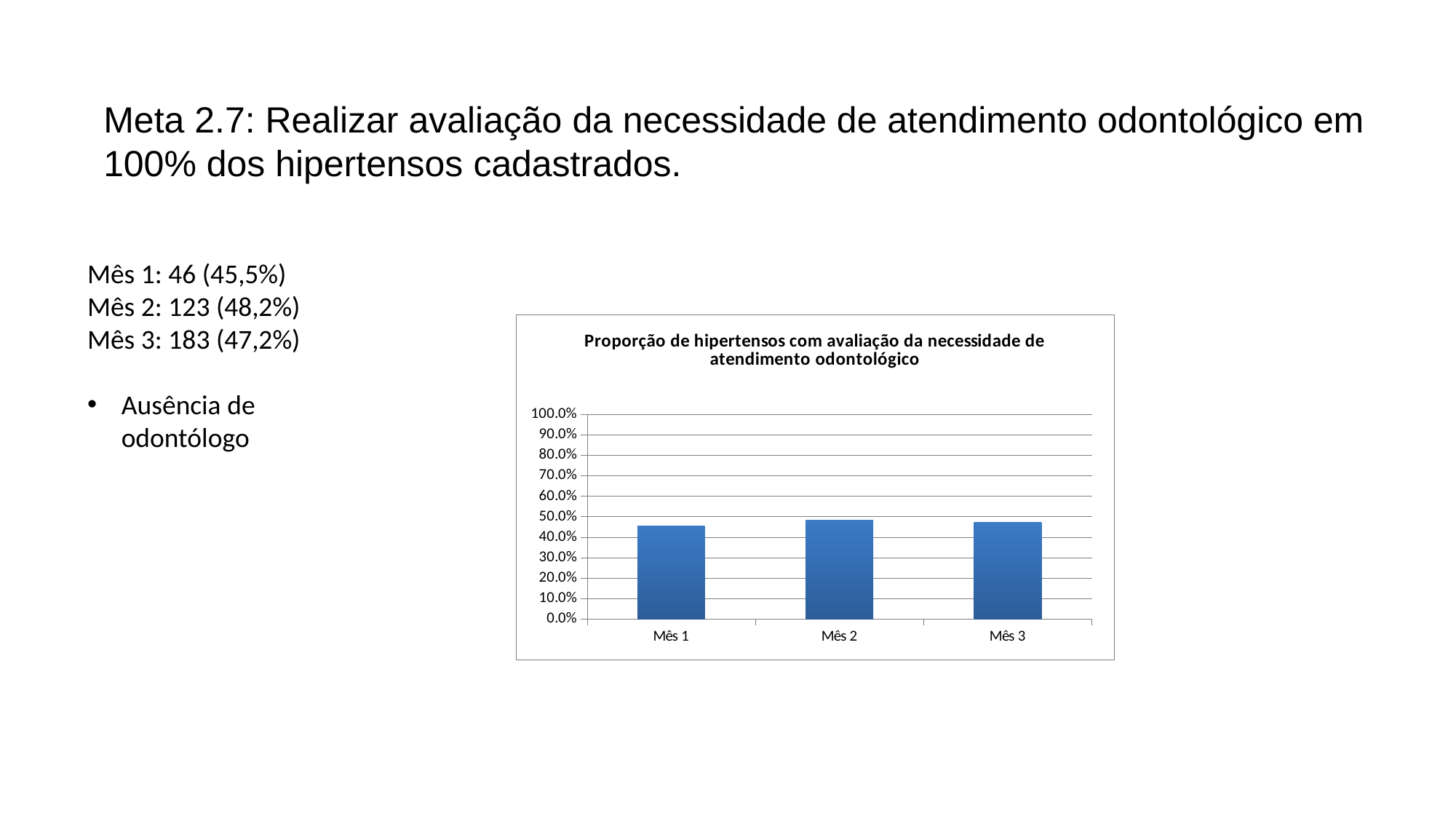
Which month has the lowest proportion in the chart? Mês 1 How many categories (months) are plotted in the chart? 3 Which is larger, the value for Mês 1 or the value for Mês 2? Mês 2 Is the value for Mês 3 greater or less than 50.0%? less Is the value for Mês 1 greater or less than 50.0%? less What is the title of the chart? Proporção de hipertensos com avaliação da necessidade de atendimento odontológico According to the slide text, what proportion corresponds to Mês 1? 45,5% Which month has the highest proportion in the chart? Mês 2 What type of chart is shown on the slide? bar chart Is the value for Mês 2 greater or less than 40.0%? greater According to the slide text, what proportion corresponds to Mês 3? 47,2% What is the highest value shown on the vertical axis of the chart? 100.0%